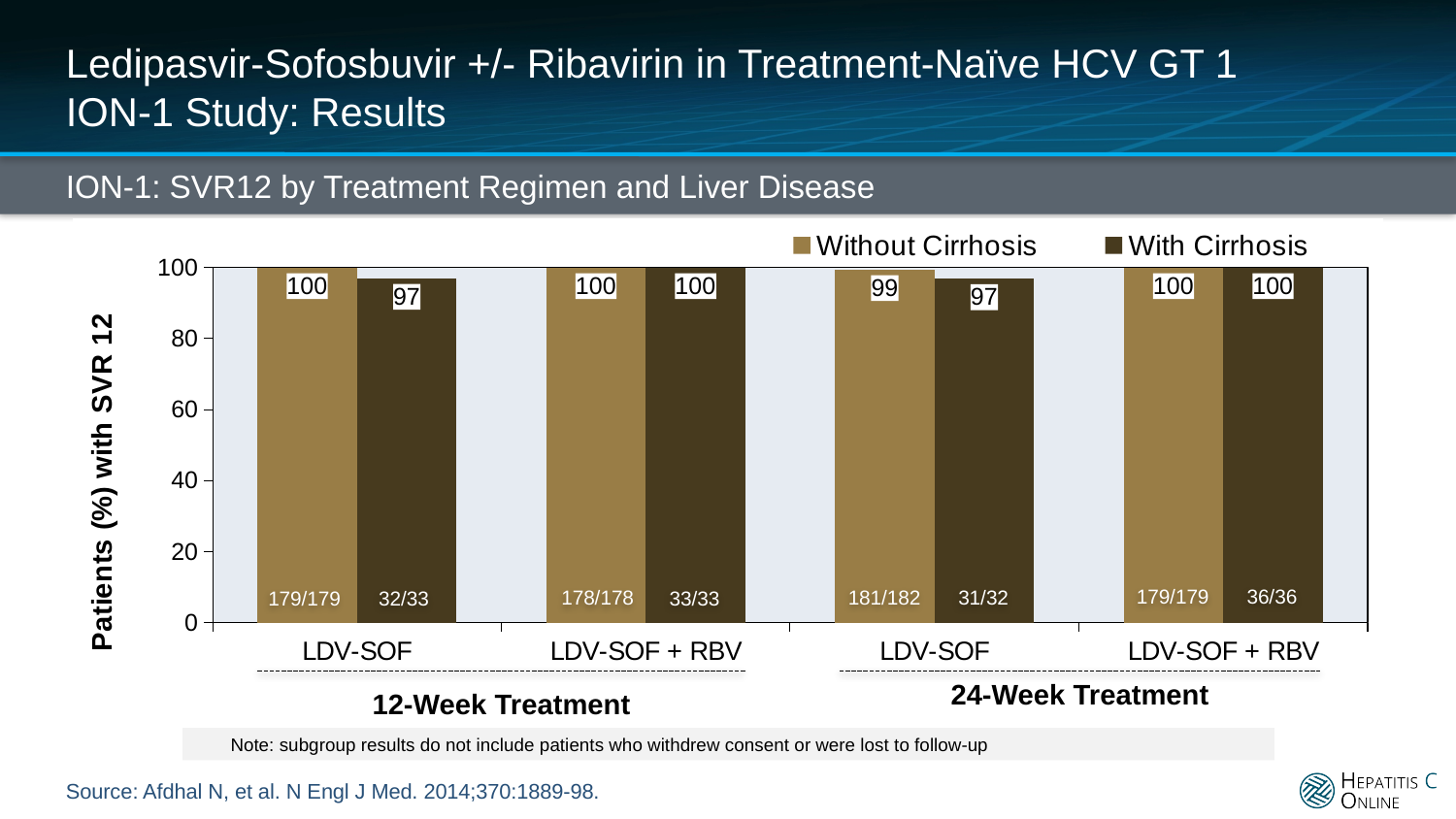
What is the SVR12 rate for patients with cirrhosis receiving LDV-SOF + RBV in the 24-week treatment group? 100 Which bar shows the lowest SVR12 rate in the chart? With Cirrhosis, LDV-SOF (both 12-week and 24-week, 97) What is the difference between the Without Cirrhosis and With Cirrhosis SVR12 rates for LDV-SOF in the 12-week treatment group? 3 What type of chart is shown on the slide? Bar chart What is the label of the y axis? Patients (%) with SVR 12 Which is larger for LDV-SOF in the 24-week treatment group: the SVR12 rate without cirrhosis or with cirrhosis? Without cirrhosis What fraction is shown on the With Cirrhosis bar for LDV-SOF + RBV in the 12-week treatment group? 33/33 How many patients without cirrhosis achieved SVR12 with LDV-SOF in the 24-week treatment group, as shown by the fraction on the bar? 181/182 How many series does the legend list? 2 What is the SVR12 rate for patients without cirrhosis receiving LDV-SOF in the 24-week treatment group? 99 How many treatment regimen categories are shown on the x axis? 4 What is the SVR12 rate for patients with cirrhosis receiving LDV-SOF in the 12-week treatment group? 97